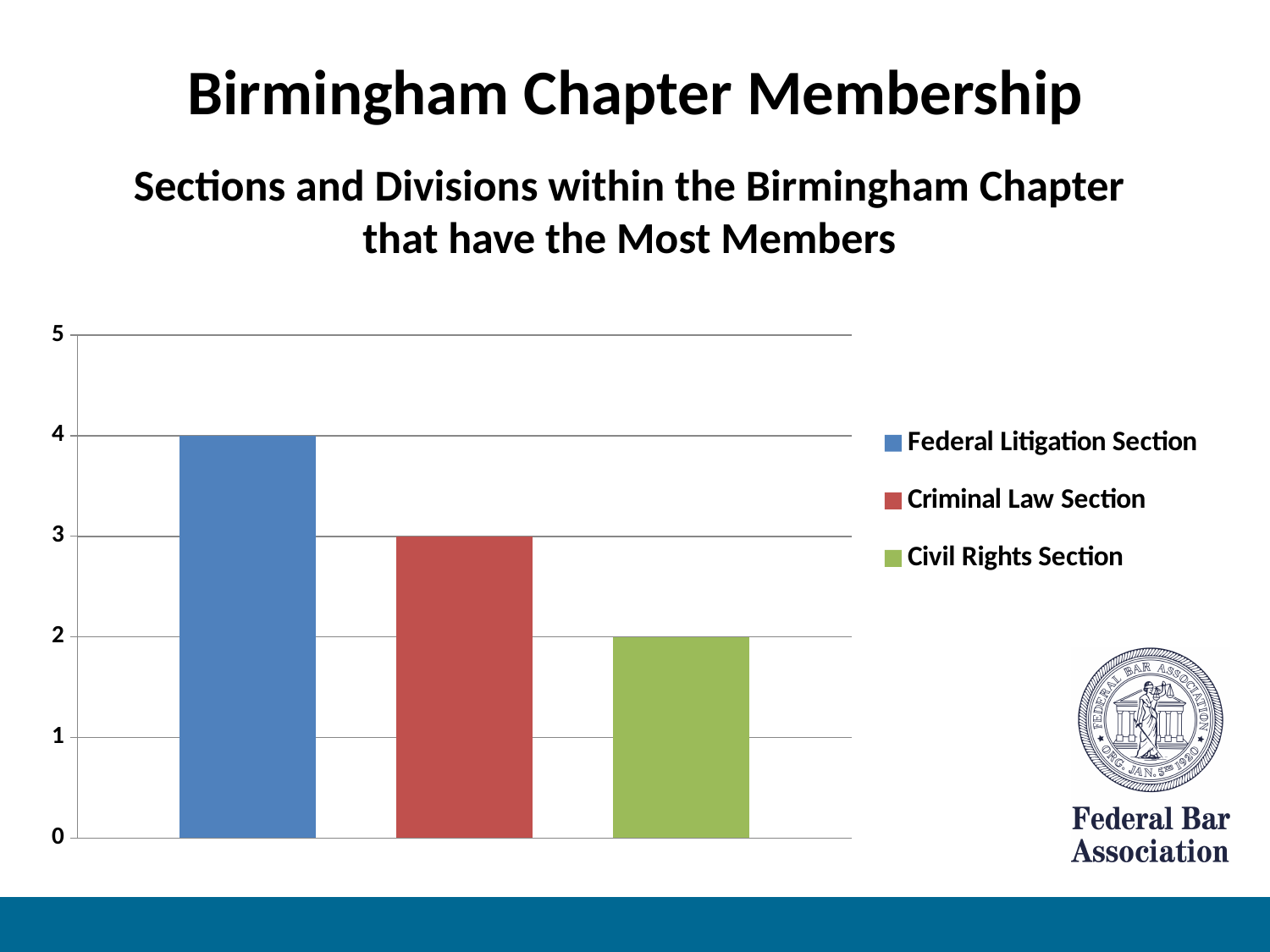
Which section has the highest value? Federal Litigation Section What is the difference between the Criminal Law Section and the Civil Rights Section? 1 Which is larger, the Criminal Law Section or the Civil Rights Section? Criminal Law Section Is the value for the Federal Litigation Section greater or less than 3? greater What kind of chart is shown on the slide? Bar chart What is the value for the Federal Litigation Section? 4 How many entries does the legend list? 3 What is the value for the Criminal Law Section? 3 How many bars are shown in the chart? 3 What is the value for the Civil Rights Section? 2 Which section has the lowest value? Civil Rights Section What is the difference between the Federal Litigation Section and the Civil Rights Section? 2